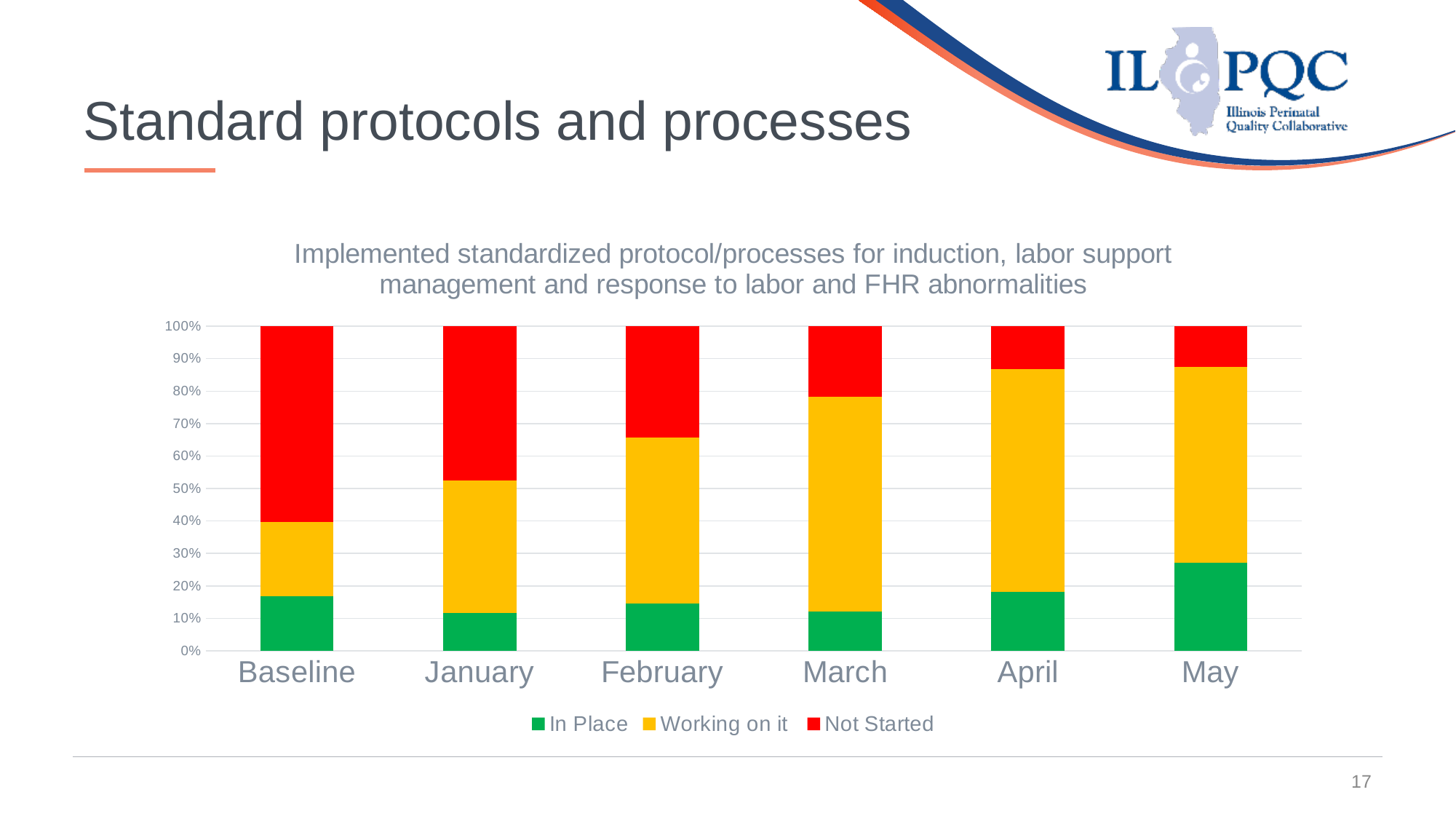
Which category has the highest In Place share? May Does the Not Started share rise or fall from Baseline to May? fall Is the Not Started value for Baseline greater or less than 50%? greater What kind of chart is shown on the slide? stacked bar chart Is the Not Started value for March greater or less than 30%? less Is the Working on it value for April greater or less than 60%? greater Which has the larger Not Started share, January or February? January What colour represents the Not Started series in the legend? red How many categories are shown along the x axis? 6 Which category has the highest Not Started share? Baseline How many series does the legend list? 3